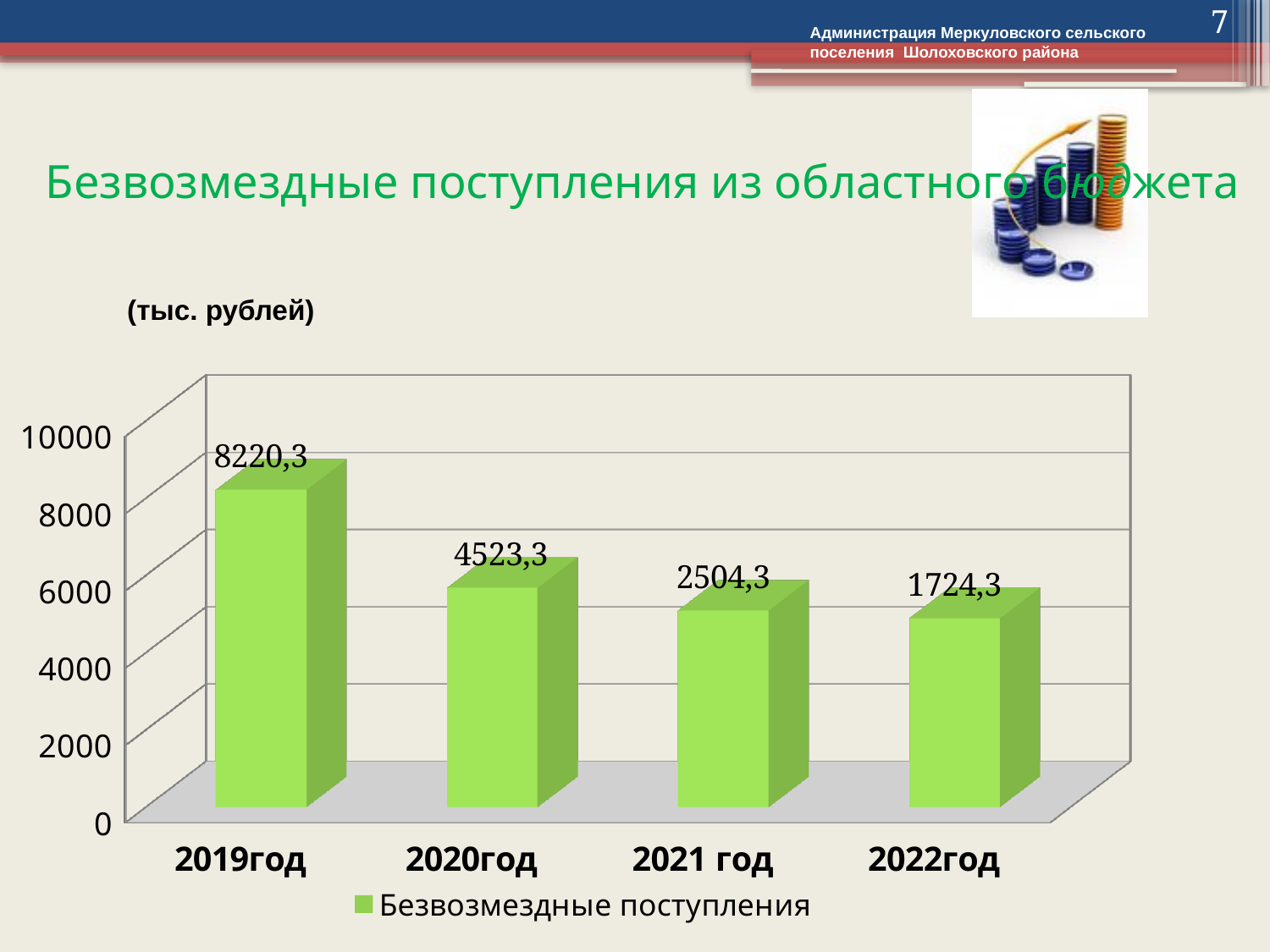
What is the difference between the values for 2021 год and 2022год? 780 Do the values rise or fall from 2019год to 2022год? fall How many years are shown on the x axis? 4 Which is larger, the value for 2020год or the value for 2021 год? 2020год What is the value for 2021 год? 2504,3 What is the value for 2020год? 4523,3 Which year has the lowest value? 2022год What is the value for 2022год? 1724,3 What kind of chart is shown on the slide? bar chart What is the value for 2019год? 8220,3 Which year has the highest value? 2019год What is the difference between the values for 2019год and 2020год? 3697